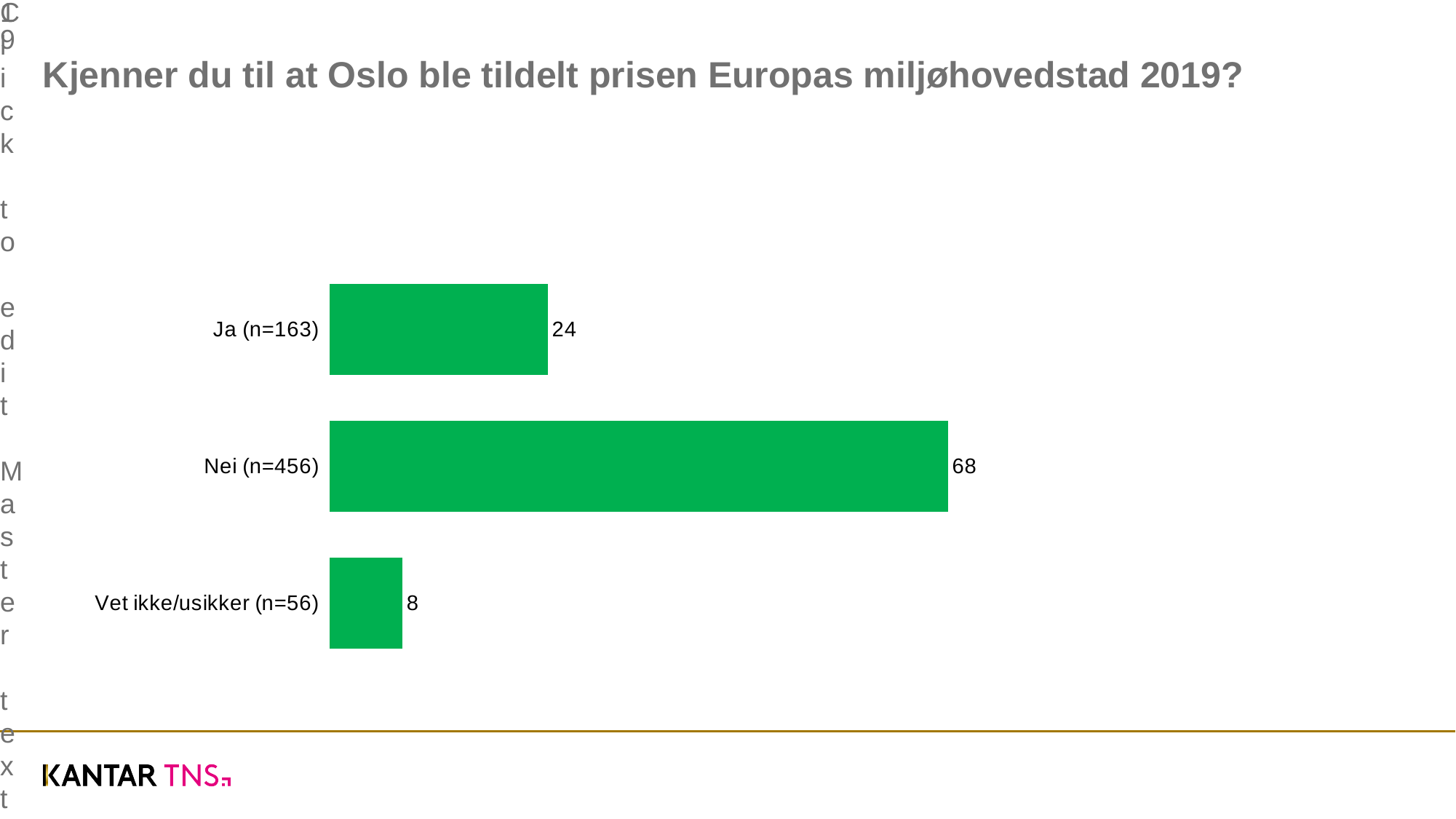
What is the total of the three values shown in the chart? 100 What is the value for Nei (n=456)? 68 What is the difference between the values for Ja (n=163) and Vet ikke/usikker (n=56)? 16 How many categories are shown in the chart? 3 Which is larger, the value for Ja (n=163) or the value for Vet ikke/usikker (n=56)? Ja (n=163) What kind of chart is shown on the slide? Bar chart Which category has the highest value? Nei (n=456) Which category has the lowest value? Vet ikke/usikker (n=56) What is the difference between the values for Nei (n=456) and Ja (n=163)? 44 What is the value for Vet ikke/usikker (n=56)? 8 What is the title of the slide? Kjenner du til at Oslo ble tildelt prisen Europas miljøhovedstad 2019? What is the value for Ja (n=163)? 24